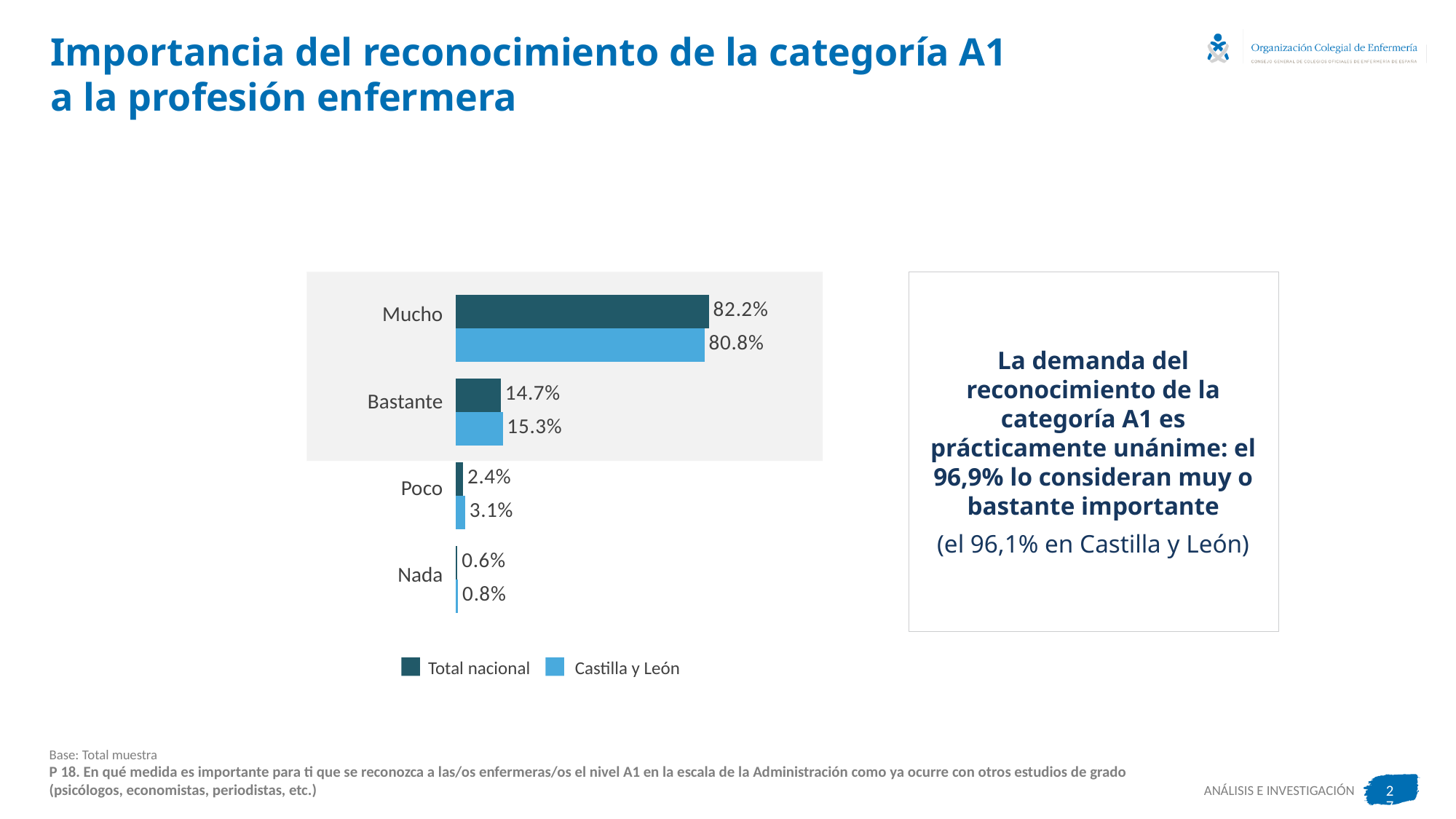
What is the value for Poco in the Total nacional series? 2.4% What kind of chart is shown on the slide? Bar chart What is the value for Bastante in the Castilla y León series? 15.3% How many series does the legend list? 2 What is the difference between the Total nacional and Castilla y León values for Mucho? 1.4% What are the two series named in the legend? Total nacional and Castilla y León Which category has the highest value in the Total nacional series? Mucho What is the value for Mucho in the Total nacional series? 82.2% Which category has the lowest value in the Castilla y León series? Nada What is the value for Nada in the Castilla y León series? 0.8% How many categories are shown in the chart? 4 For Bastante, which series has the larger value, Total nacional or Castilla y León? Castilla y León